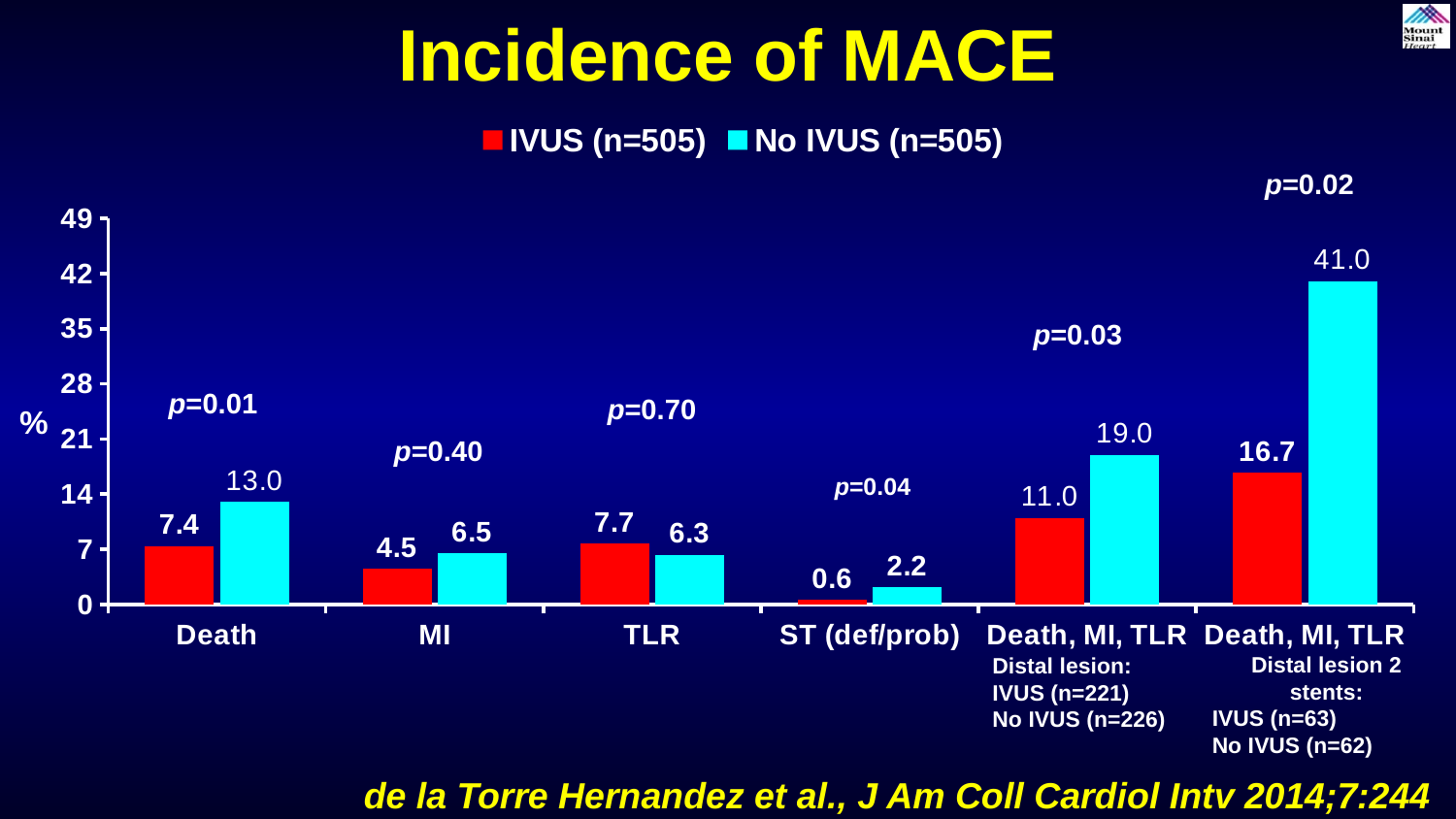
What is the No IVUS value for MI? 6.5 What kind of chart is shown on the slide? Bar chart Which category has the lowest IVUS value? ST (def/prob) What is the IVUS value for ST (def/prob)? 0.6 Which category has the highest No IVUS value? Death, MI, TLR (Distal lesion 2 stents) How many series does the legend list? 2 How many categories are shown on the x axis? 6 What is the difference between the No IVUS and IVUS values for Death? 5.6 What is the p-value shown above the Death, MI, TLR category with distal lesion 2 stents? p=0.02 What is the No IVUS value for the Death, MI, TLR category with distal lesion 2 stents? 41.0 For TLR, which is larger: the IVUS value or the No IVUS value? IVUS What is the IVUS value for Death? 7.4